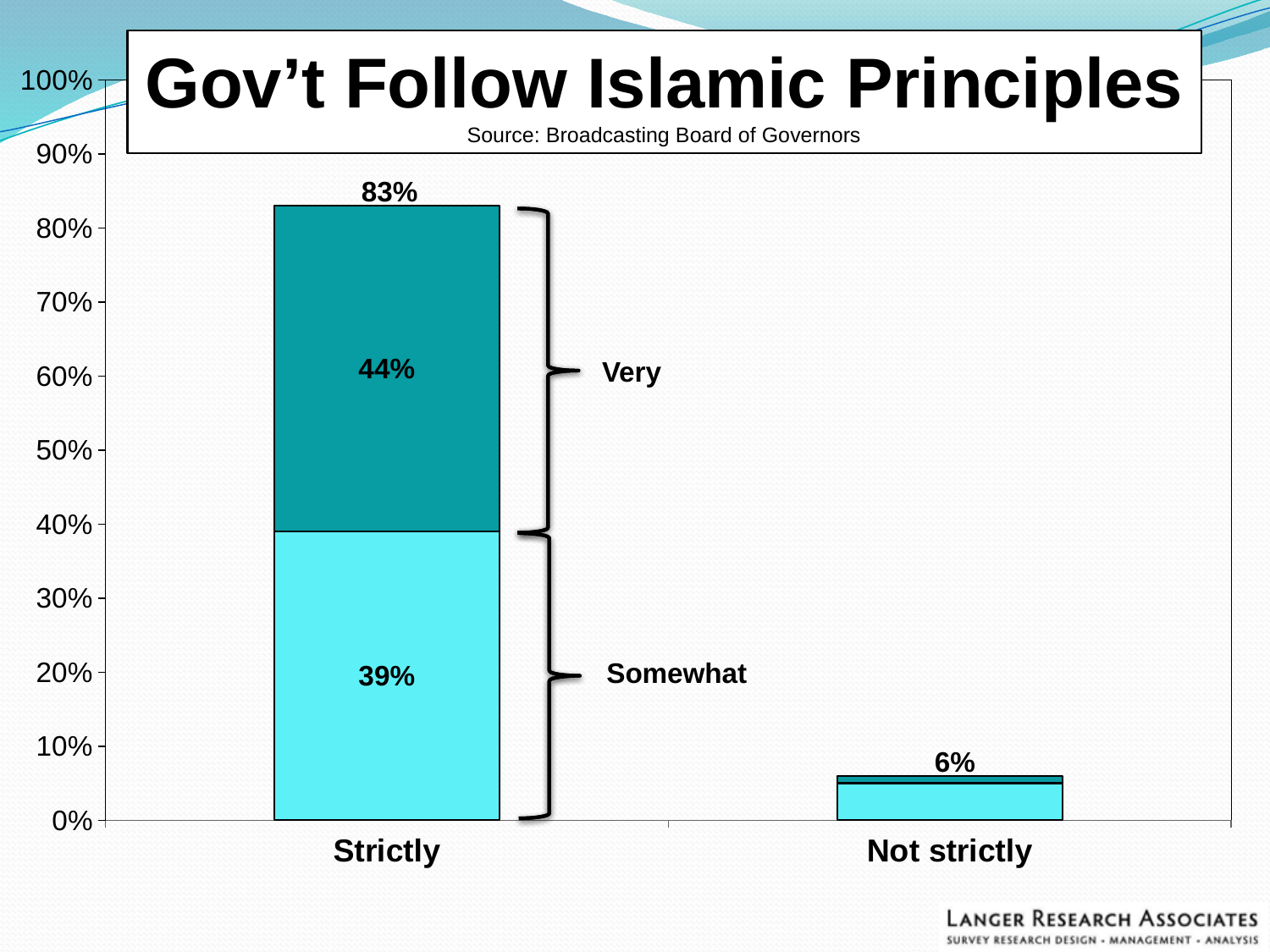
What is the total value of the Not strictly bar? 6% What is the difference between the Strictly total and the Not strictly total? 77% What kind of chart is shown on the slide? Stacked bar chart What is the title of the chart? Gov't Follow Islamic Principles Which category has the higher total, Strictly or Not strictly? Strictly Is the total for Not strictly greater or less than 10%? less What is the total value of the Strictly bar? 83% How many categories are shown on the x axis? 2 What is the Very segment value for Strictly? 44% What is the difference between the Very and Somewhat segments in the Strictly bar? 5% Which category has the lowest total value? Not strictly What is the Somewhat segment value for Strictly? 39%